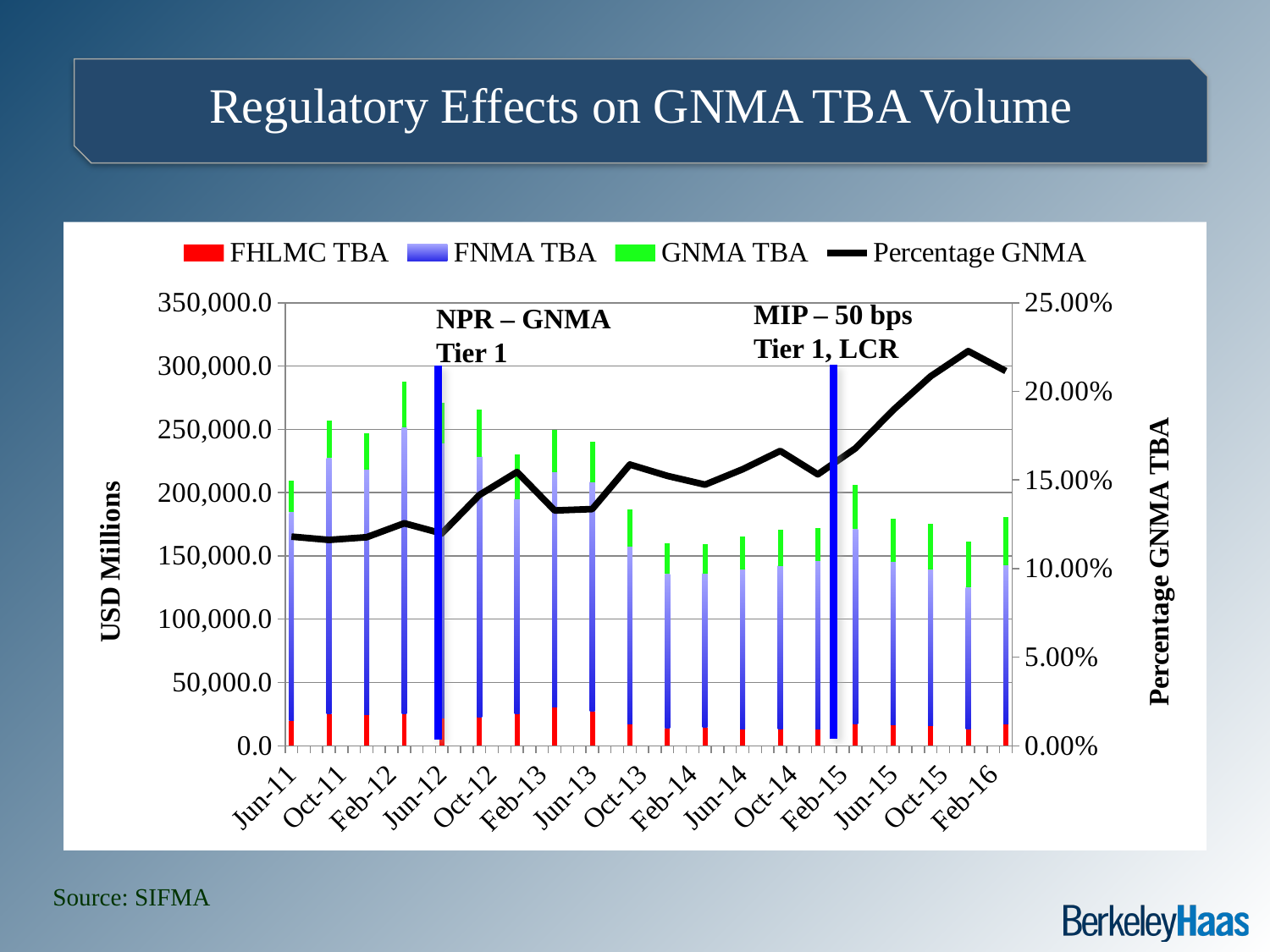
Is the total stacked bar value at Feb-14 greater or less than 200,000.0? less Is the Percentage GNMA value at Feb-16 greater or less than 20.00%? greater Which is larger, the Percentage GNMA value at Feb-16 or at Jun-11? Feb-16 How many date labels are shown on the x axis? 15 What is the title of the chart on the slide? Regulatory Effects on GNMA TBA Volume Does the Percentage GNMA line generally rise or fall from Jun-11 to Feb-16? rise What kind of chart is shown on the slide? Stacked bar chart with a line series How many series does the chart legend list? 4 Is the Percentage GNMA value at Oct-13 greater or less than 20.00%? less Which series is plotted as a line rather than bars? Percentage GNMA